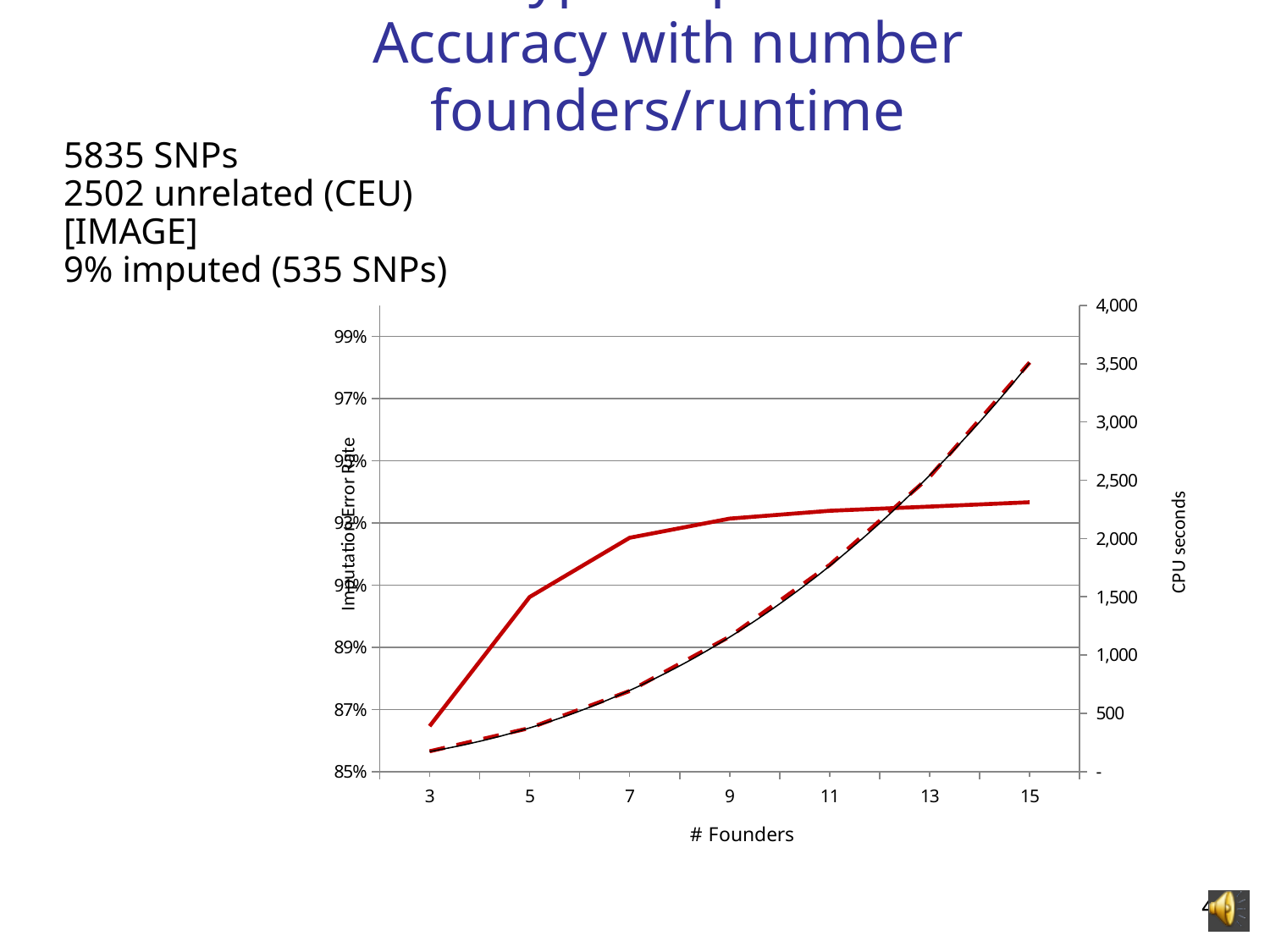
How many founder values are labelled on the x axis of the chart? 7 Does the dashed red line rise or fall as the number of founders increases from 3 to 15? rises What kind of chart is shown on the slide? line chart Is the value of the solid red line at 15 founders greater or less than 91%? greater What is the title of the x axis of the chart? # Founders Does the solid red line rise or fall as the number of founders increases from 3 to 15? rises Is the value of the dashed red line (CPU seconds) at 15 founders greater or less than 3,000? greater Is the value of the solid red line at 3 founders greater or less than 87%? less What is the title of the right-hand y axis of the chart? CPU seconds